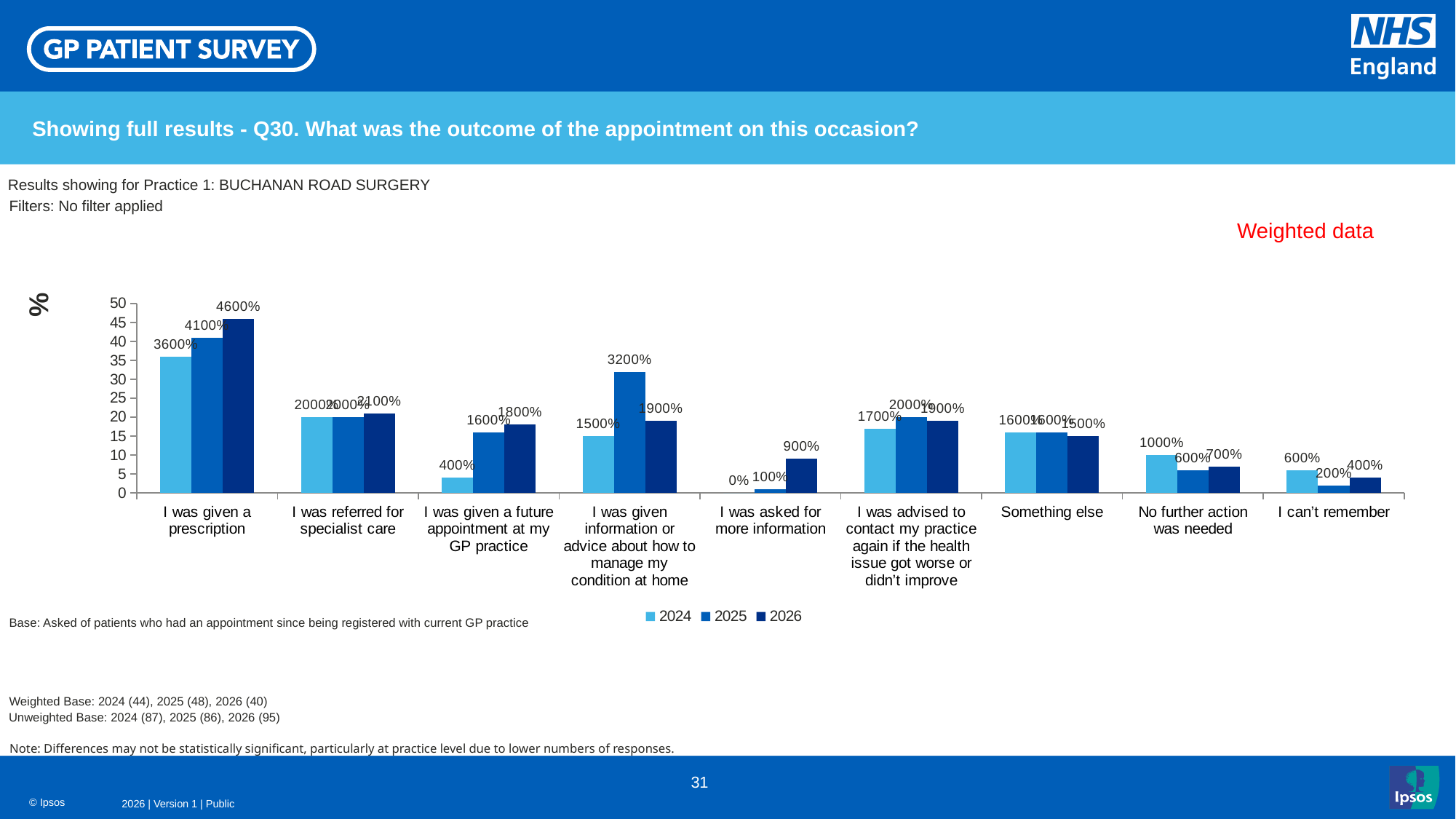
What is the 2024 value for "I was given a future appointment at my GP practice"? 400% What is the 2024 value for "I was given information or advice about how to manage my condition at home"? 1500% Which category has the lowest 2024 value? I was asked for more information What is the 2026 value for "I was asked for more information"? 900% Which category has the highest 2026 value? I was given a prescription How many categories are shown on the x axis? 9 What is the 2025 value for "I was given information or advice about how to manage my condition at home"? 3200% What kind of chart is shown on the slide? Bar chart Do the values for "I was given a prescription" rise or fall from 2024 to 2026? Rise How many series does the legend list? 3 Which is larger for "No further action was needed": the 2024 value or the 2026 value? 2024 What is the 2026 value for "I was given a prescription"? 4600%